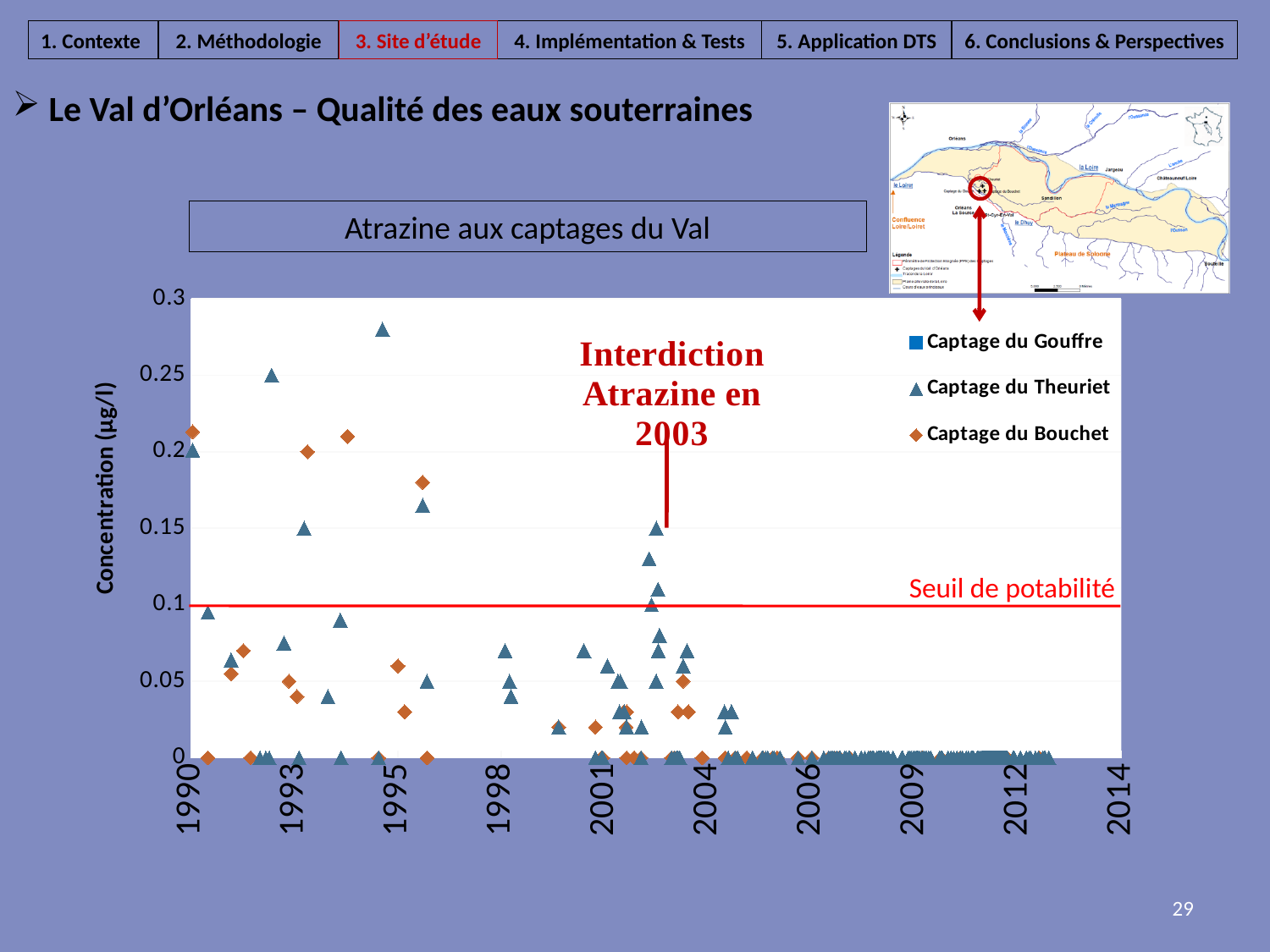
Is the highest plotted value for Captage du Theuriet greater or less than 0.25? greater Is the highest plotted value for Captage du Bouchet greater or less than 0.25? less In which year does the annotation say atrazine was banned (Interdiction Atrazine)? 2003 Which series reaches the highest concentration on the chart? Captage du Theuriet How many series does the chart legend list? 3 Is the highest plotted value for Captage du Theuriet greater or less than 0.1? greater What is the title of the chart? Atrazine aux captages du Val Do the atrazine concentrations generally rise or fall along the x axis from 1990 to 2014? fall What is the label of the vertical axis of the chart? Concentration (µg/l) What type of chart is shown on the slide? scatter chart At what concentration value is the red horizontal line labelled 'Seuil de potabilité' drawn? 0.1